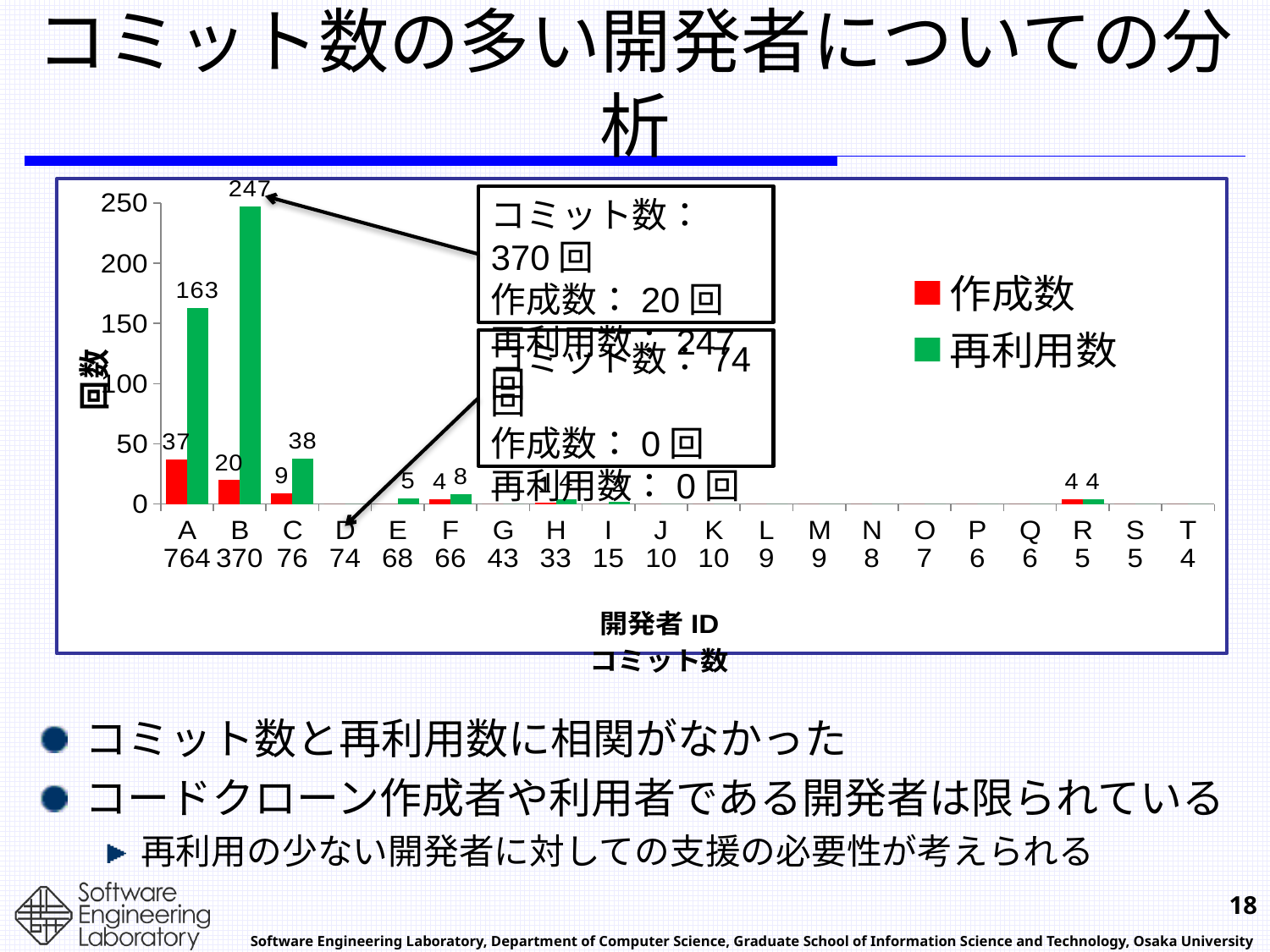
Is the 再利用数 value for developer A greater or less than 150? greater Which is larger, the 再利用数 of developer C or the 作成数 of developer C? 再利用数 of developer C What is the difference between the 再利用数 of developer B and developer A? 84 What kind of chart is shown on the slide? bar chart What is the 再利用数 value for developer A? 163 What is the 再利用数 value for developer B? 247 What is the 作成数 value for developer A? 37 How many series does the legend list? 2 Which developer has the highest 再利用数? B What is the 作成数 value for developer C? 9 Which developer has the highest 作成数? A How many developer IDs are shown on the x axis? 20